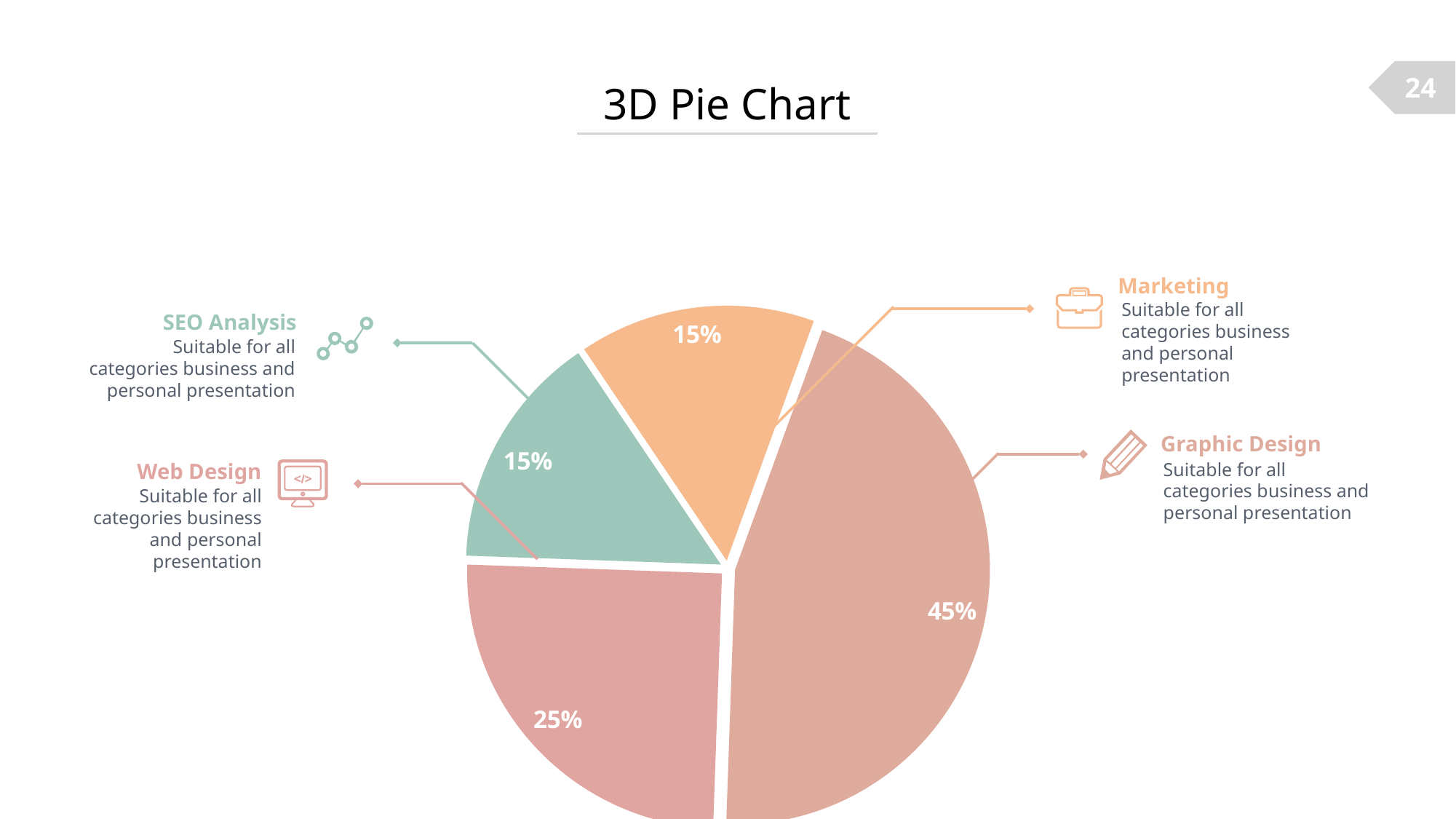
What kind of chart is shown on the slide? pie chart Which category is shown in the orange slice? Marketing Which is larger, the Web Design slice or the Marketing slice? Web Design Which category has the largest slice of the pie? Graphic Design What is the title of the chart on the slide? 3D Pie Chart How many slices does the pie chart have? 4 What is the difference between the Graphic Design share and the Web Design share? 20% What is the combined share of Marketing and SEO Analysis? 30% What share of the pie does Web Design have? 25% What share of the pie does Graphic Design have? 45% What share of the pie does SEO Analysis have? 15%